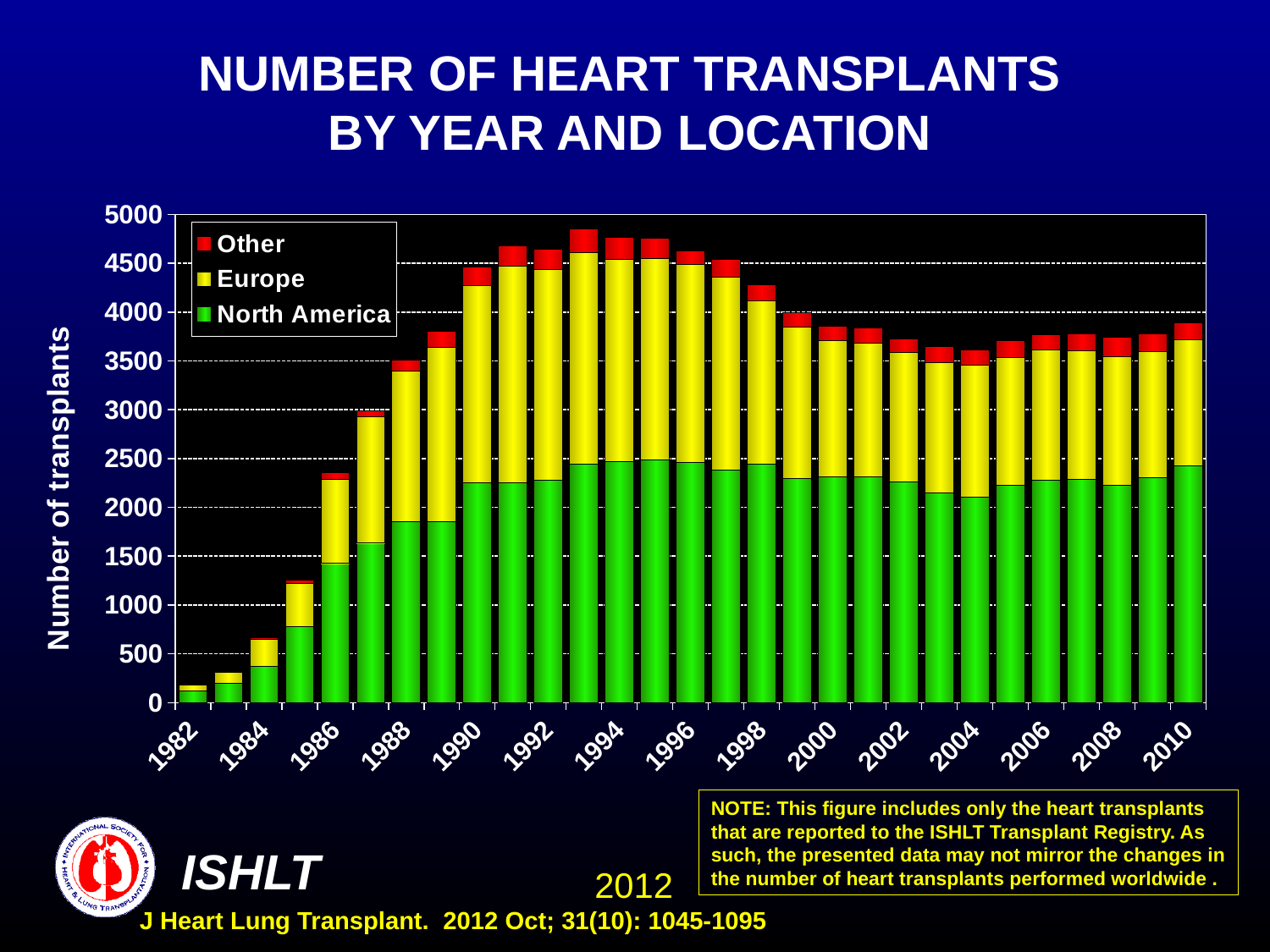
What kind of chart is shown on the slide? Stacked bar chart Which year has the highest total number of heart transplants? 1993 Do the total number of transplants rise or fall from 1982 to 1993? rise How many yearly bars are plotted in the chart? 29 Is the total number of transplants in 1982 greater or less than 500? less Is the total number of transplants in 1993 greater or less than 4500? greater Which year has the lowest total number of heart transplants? 1982 How many series does the legend list? 3 What is the label on the vertical axis? Number of transplants Which series is shown in green in the legend? North America Which year has a larger total number of transplants, 1993 or 2010? 1993 Is the North America value in 1994 greater or less than 2000? greater